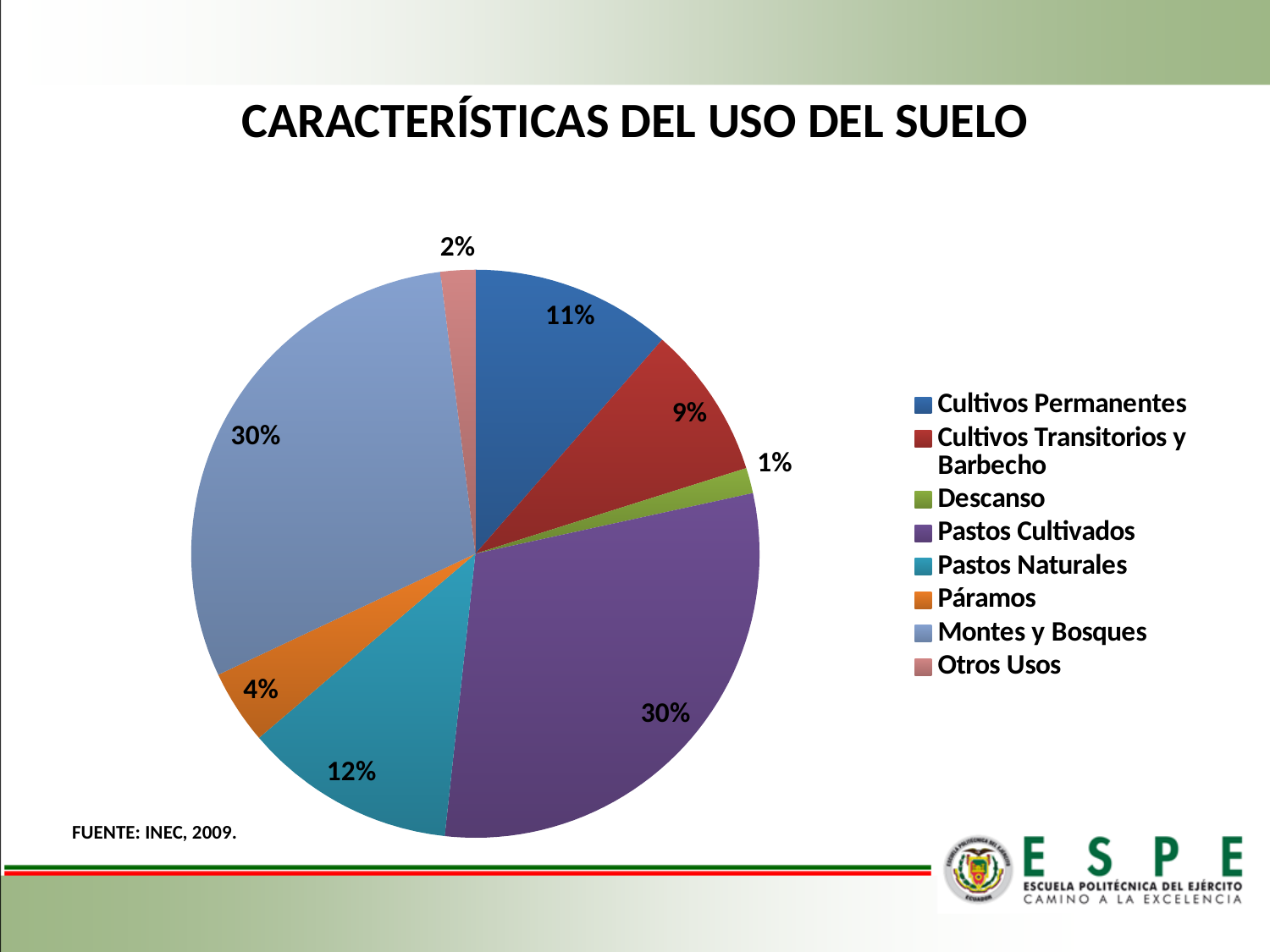
Which category has the smallest slice of the pie? Descanso What share of the pie does Páramos represent? 4% What is the difference in percentage points between Pastos Cultivados and Pastos Naturales? 18 What source is cited below the chart? FUENTE: INEC, 2009. Which is larger, the share for Cultivos Permanentes or the share for Cultivos Transitorios y Barbecho? Cultivos Permanentes What share of the pie does Cultivos Transitorios y Barbecho represent? 9% What share of the pie does Cultivos Permanentes represent? 11% What is the title of the chart? CARACTERÍSTICAS DEL USO DEL SUELO What type of chart is shown on the slide? pie chart How many categories does the pie chart show? 8